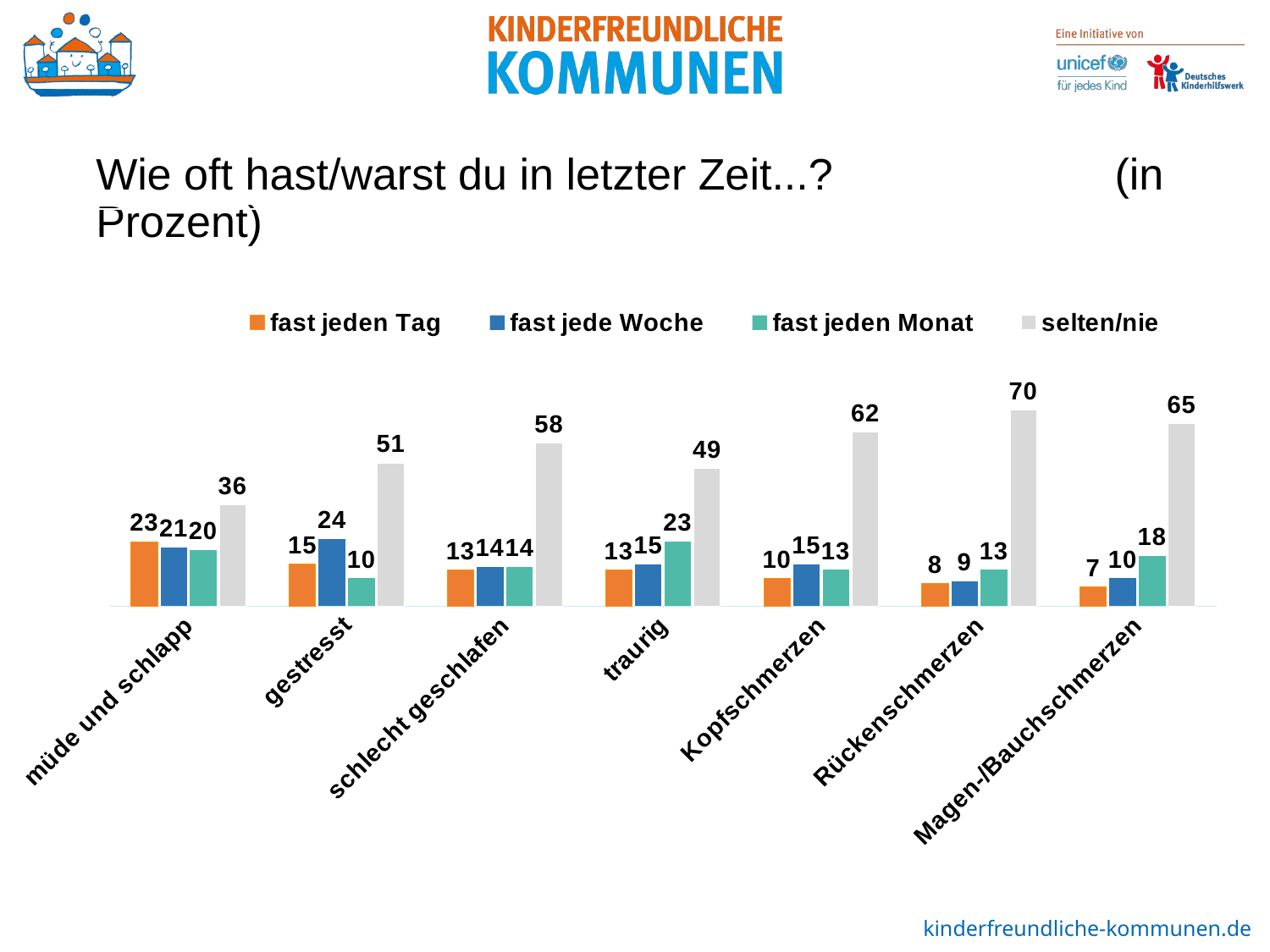
What is the value for 'fast jede Woche' in the 'gestresst' category? 24 Which category has the highest 'selten/nie' value? Rückenschmerzen What is the value for 'selten/nie' in the 'Rückenschmerzen' category? 70 How many series does the legend list? 4 What is the value for 'fast jeden Monat' in the 'Magen-/Bauchschmerzen' category? 18 What percentage of respondents reported feeling 'müde und schlapp' fast jeden Tag? 23 What is the difference between the 'selten/nie' values for 'Magen-/Bauchschmerzen' and 'müde und schlapp'? 29 Which category has the lowest 'fast jeden Tag' value? Magen-/Bauchschmerzen What type of chart is shown on the slide? bar chart Which is larger: the 'fast jeden Monat' value for 'traurig' or for 'Kopfschmerzen'? traurig Which colour represents the 'selten/nie' series? grey How many categories are shown on the x axis? 7